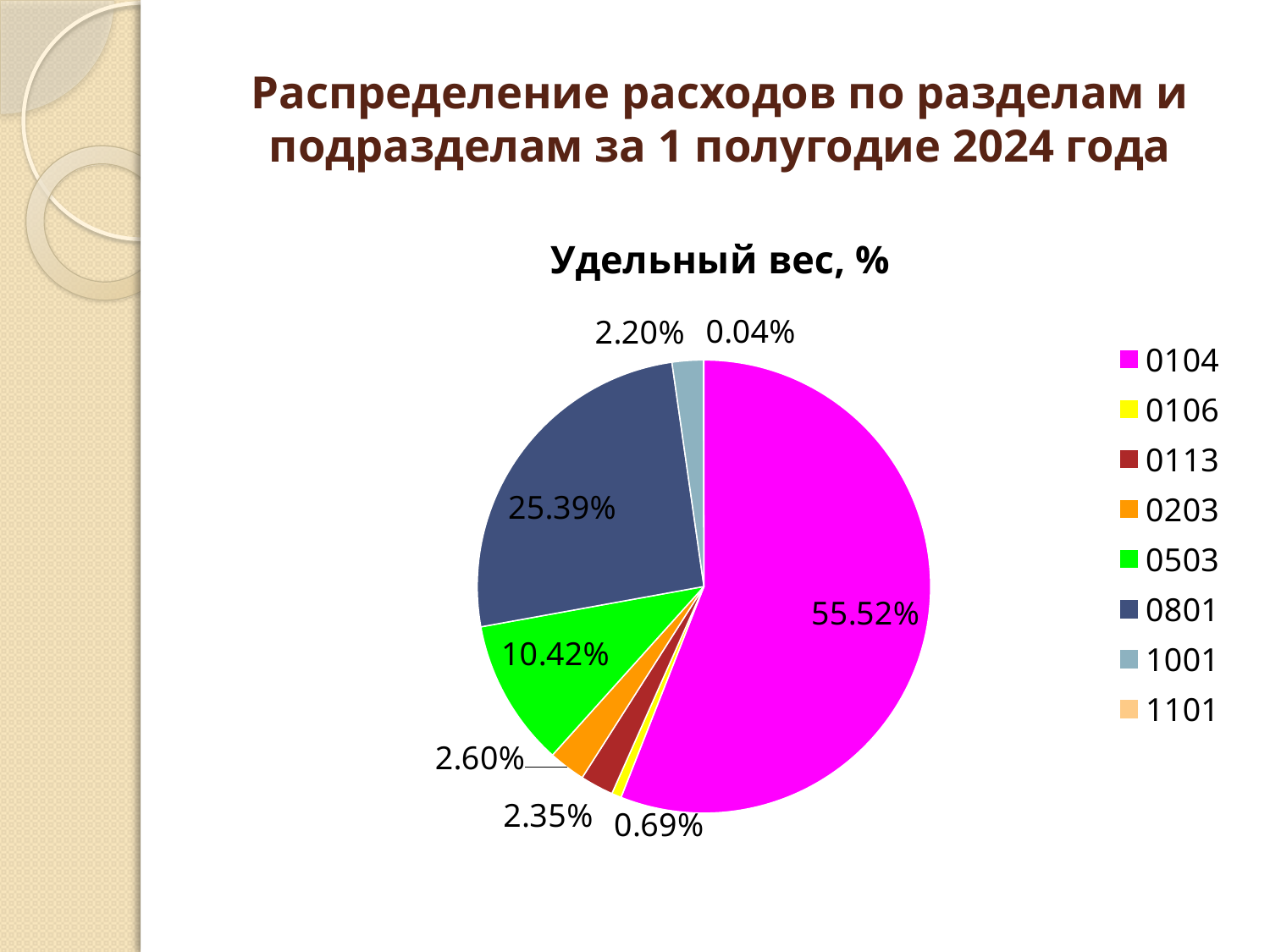
What kind of chart is shown on the slide? Pie chart Which category has the largest share of the pie? 0104 What share of the pie does category 0801 have? 25.39% Which category has the smallest share of the pie? 1101 Which has a larger share, 0203 or 0113? 0203 What share of the pie does category 0104 have? 55.52% What is the title of the chart? Удельный вес, % How many categories does the legend list? 8 What share of the pie does category 0106 have? 0.69% What share of the pie does category 0503 have? 10.42% What is the difference between the shares of 0104 and 0801? 30.13% What share of the pie does category 1101 have? 0.04%